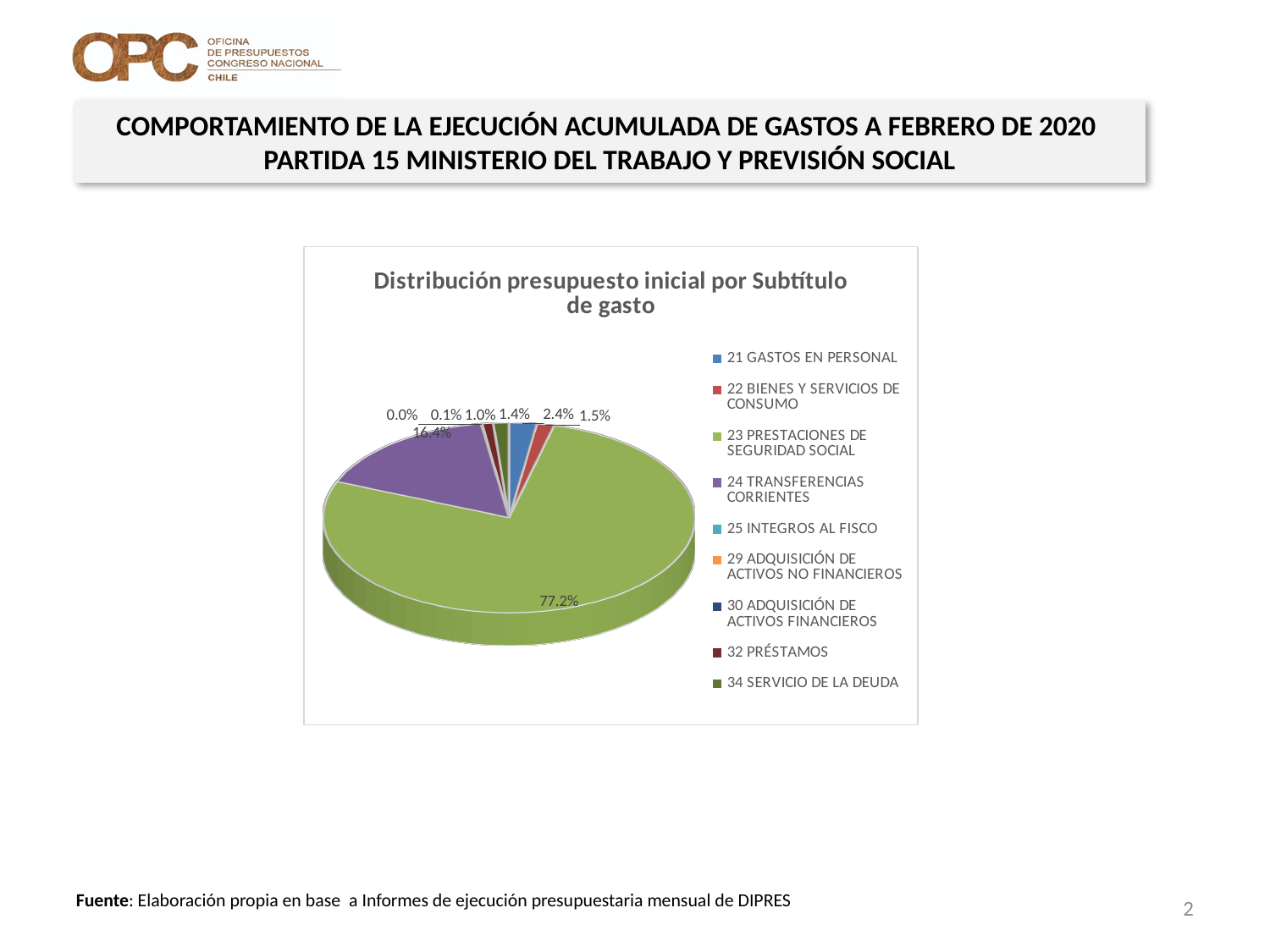
Which category has the largest share of the pie? 23 PRESTACIONES DE SEGURIDAD SOCIAL What type of chart is shown on the slide? Pie chart What is the smallest percentage value labelled on the pie? 0.0% What is the title of the chart? Distribución presupuesto inicial por Subtítulo de gasto What is the difference in percentage points between the share for 23 PRESTACIONES DE SEGURIDAD SOCIAL and the share for 24 TRANSFERENCIAS CORRIENTES? 60.8 percentage points What share of the pie does 22 BIENES Y SERVICIOS DE CONSUMO represent? 1.5% How many categories does the chart's legend list? 9 What share of the pie does 23 PRESTACIONES DE SEGURIDAD SOCIAL represent? 77.2% What colour is the slice for 23 PRESTACIONES DE SEGURIDAD SOCIAL? Green What share of the pie does 21 GASTOS EN PERSONAL represent? 2.4% Which is larger: the share for 23 PRESTACIONES DE SEGURIDAD SOCIAL or for 24 TRANSFERENCIAS CORRIENTES? 23 PRESTACIONES DE SEGURIDAD SOCIAL